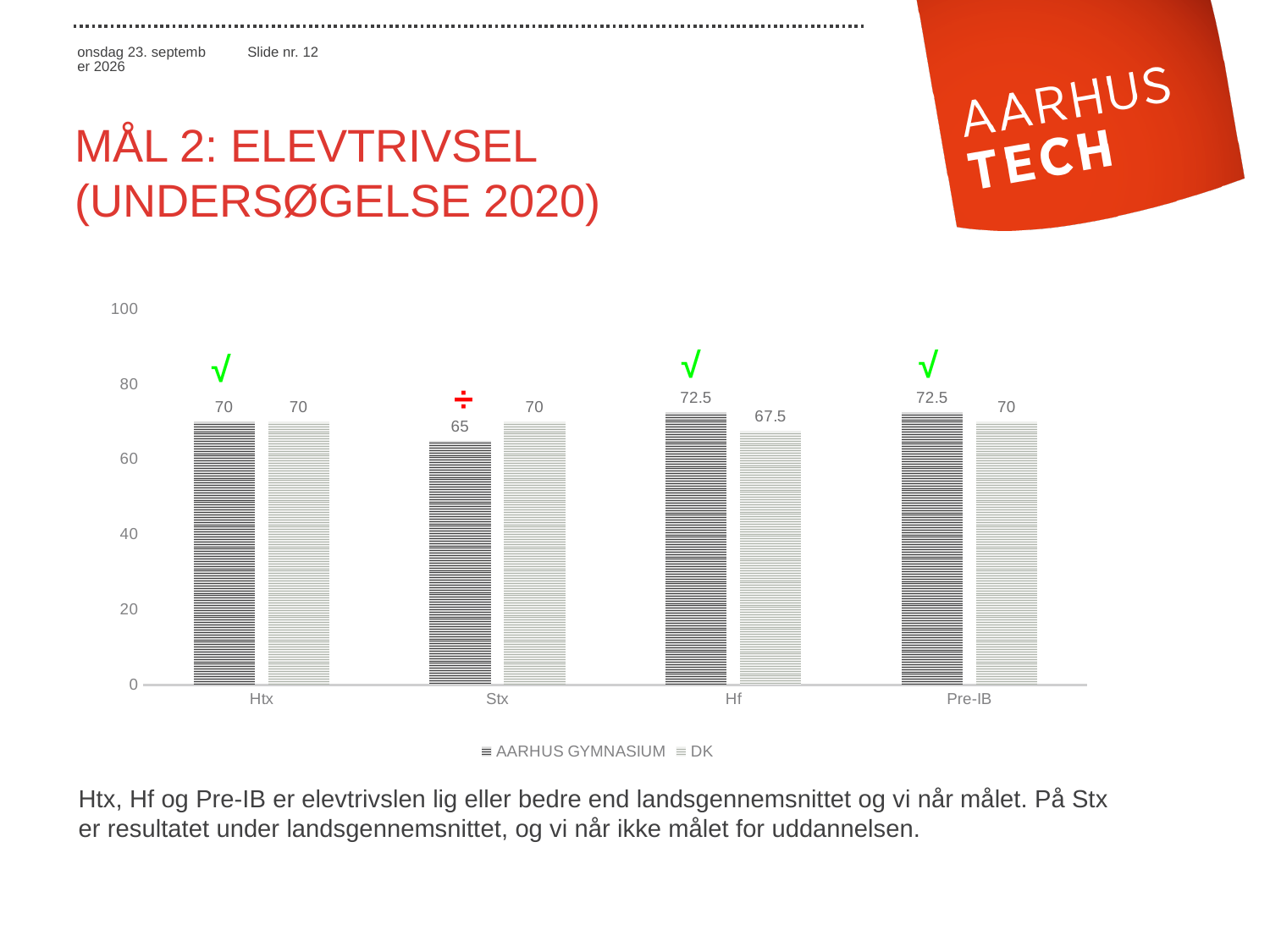
What is the difference between the AARHUS GYMNASIUM and DK values for Hf? 5 Which category has the lowest DK value? Hf What is the AARHUS GYMNASIUM value for Pre-IB? 72.5 How many series does the legend list? 2 How many categories are shown on the x axis? 4 What is the AARHUS GYMNASIUM value for Stx? 65 Which category has the lowest AARHUS GYMNASIUM value? Stx What is the DK value for Htx? 70 What kind of chart is shown on the slide? Bar chart What is the DK value for Hf? 67.5 What is the difference between the DK and AARHUS GYMNASIUM values for Stx? 5 Which is larger for Pre-IB, the AARHUS GYMNASIUM value or the DK value? AARHUS GYMNASIUM